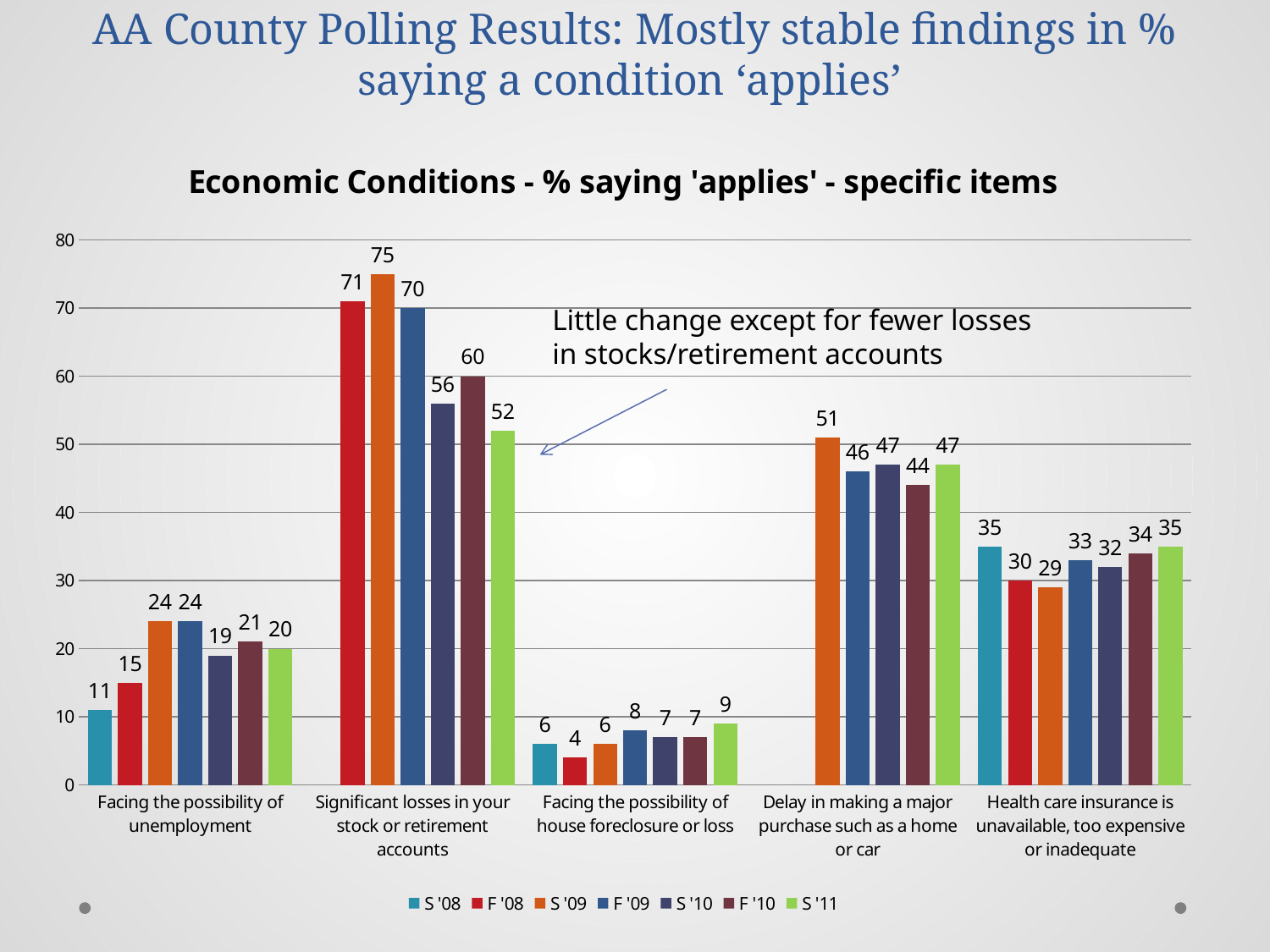
What is the S '11 value for 'Significant losses in your stock or retirement accounts'? 52 Which series has the lowest value for 'Facing the possibility of unemployment'? S '08 What is the F '08 value for 'Facing the possibility of house foreclosure or loss'? 4 What type of chart is shown on the slide? bar chart What is the difference between the S '09 and S '11 values for 'Significant losses in your stock or retirement accounts'? 23 How many series does the legend list? 7 Which series has the highest value for 'Significant losses in your stock or retirement accounts'? S '09 Which is larger for 'Health care insurance is unavailable, too expensive or inadequate': the S '08 value or the S '09 value? S '08 What is the S '09 value for 'Delay in making a major purchase such as a home or car'? 51 How many categories are shown on the x axis? 5 Is the S '11 value for 'Delay in making a major purchase such as a home or car' greater or less than 40? greater What is the title of the chart? Economic Conditions - % saying 'applies' - specific items